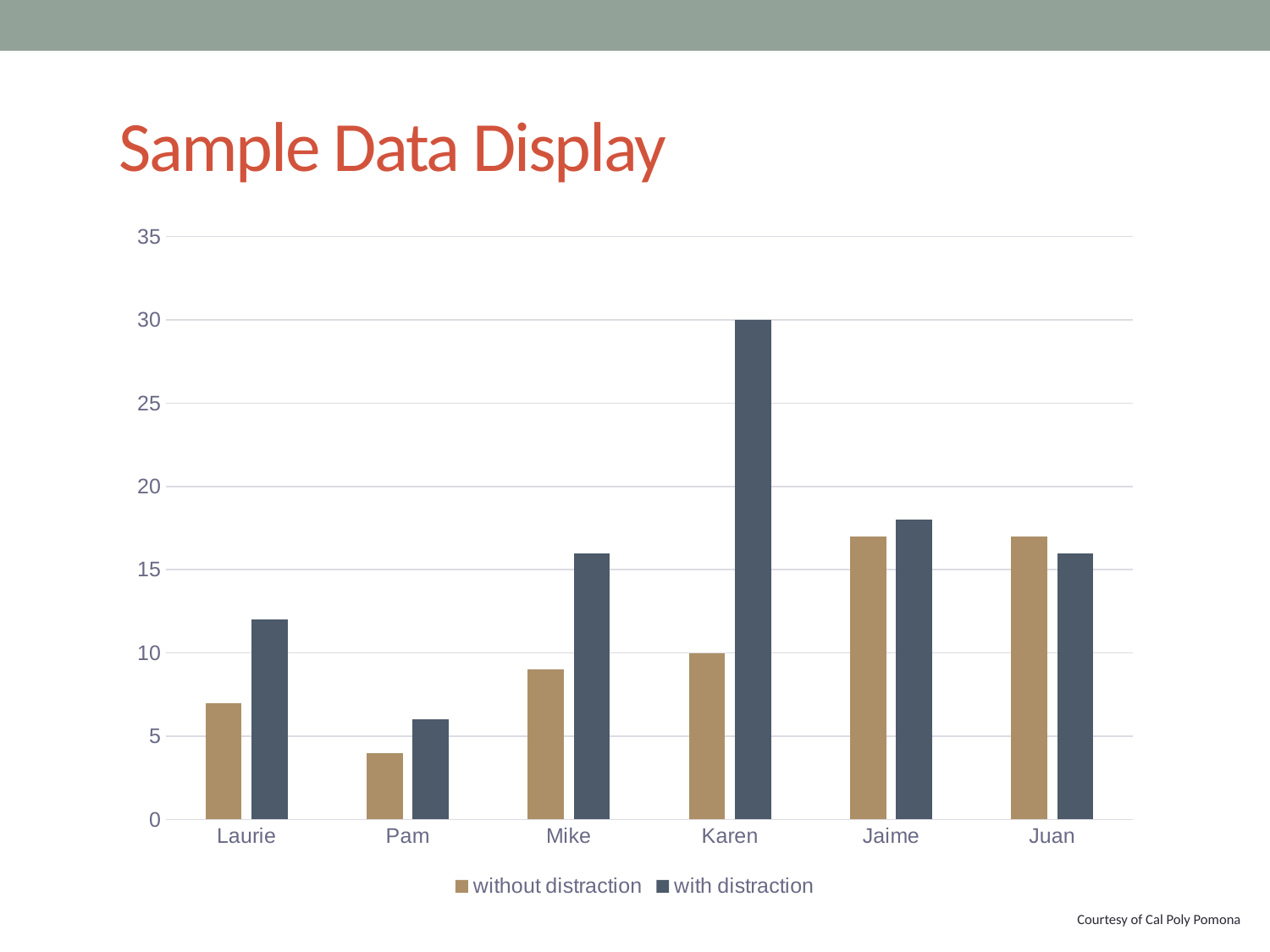
Which person has the lowest value in the 'with distraction' series? Pam Is the 'without distraction' value for Pam greater or less than 5? less How many people (categories) are shown on the x axis? 6 Which person has the lowest value in the 'without distraction' series? Pam Which person has the highest value in the 'with distraction' series? Karen What is the value for Karen in the 'with distraction' series? 30 What is the difference between Karen's 'with distraction' and 'without distraction' values? 20 What type of chart is shown on the slide? bar chart Is the 'with distraction' value for Mike greater or less than 15? greater How many series does the legend list? 2 For Laurie, which is larger: the 'without distraction' value or the 'with distraction' value? with distraction What is the value for Karen in the 'without distraction' series? 10